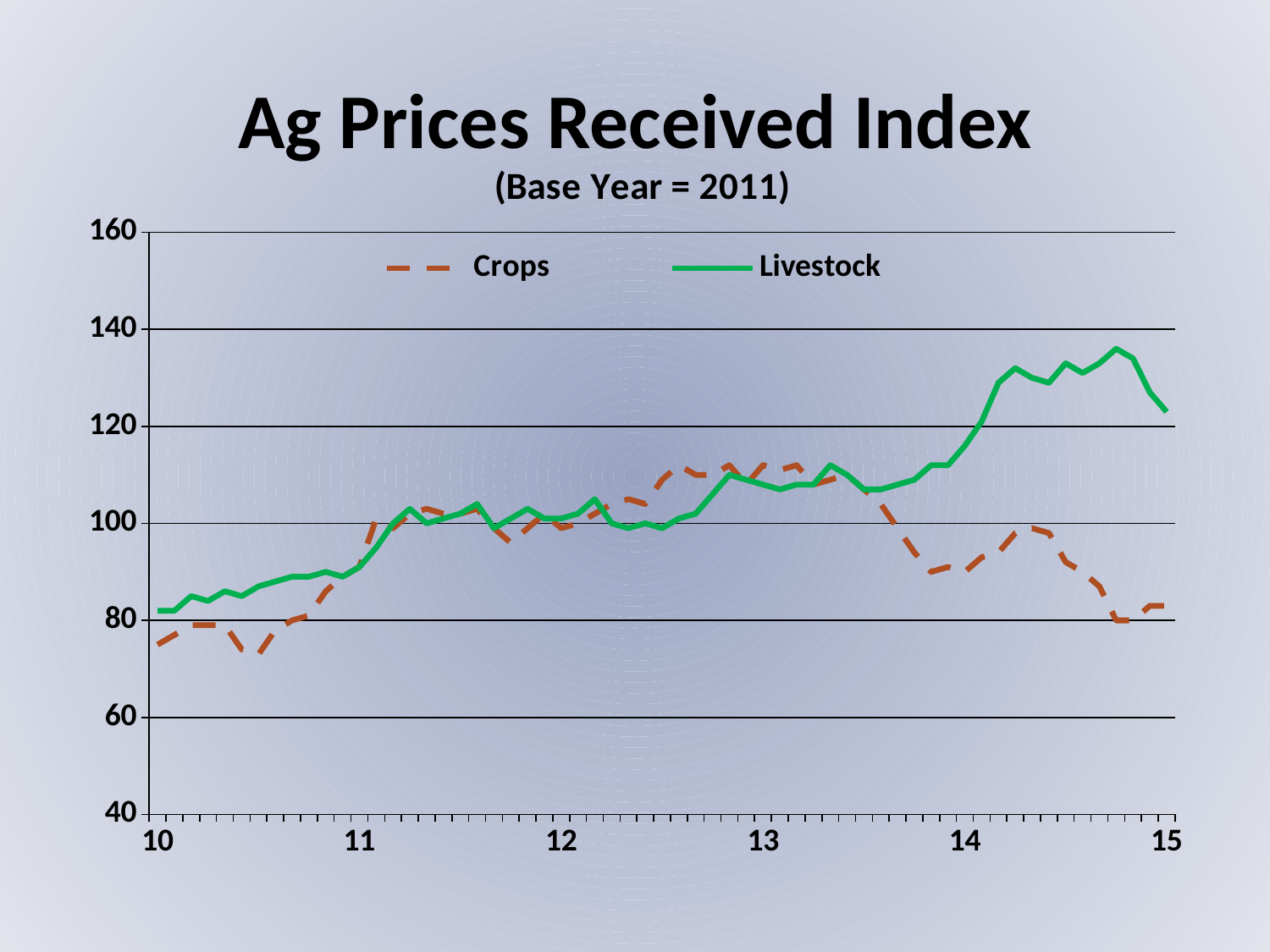
Is the value of the Livestock line at 14 greater or less than 100? greater How many series does the legend list? 2 Is the value of the Crops line at 10 greater or less than 80? less What kind of chart is shown on the slide? line chart At 10, which series has the higher value, Crops or Livestock? Livestock Is the highest value reached by the Livestock line greater or less than 120? greater At 15, which series has the higher value, Crops or Livestock? Livestock What is the title of the chart? Ag Prices Received Index Which series reaches the highest value anywhere on the chart? Livestock What are the two series named in the legend? Crops and Livestock Does the Crops line generally rise or fall between 14 and 15? fall